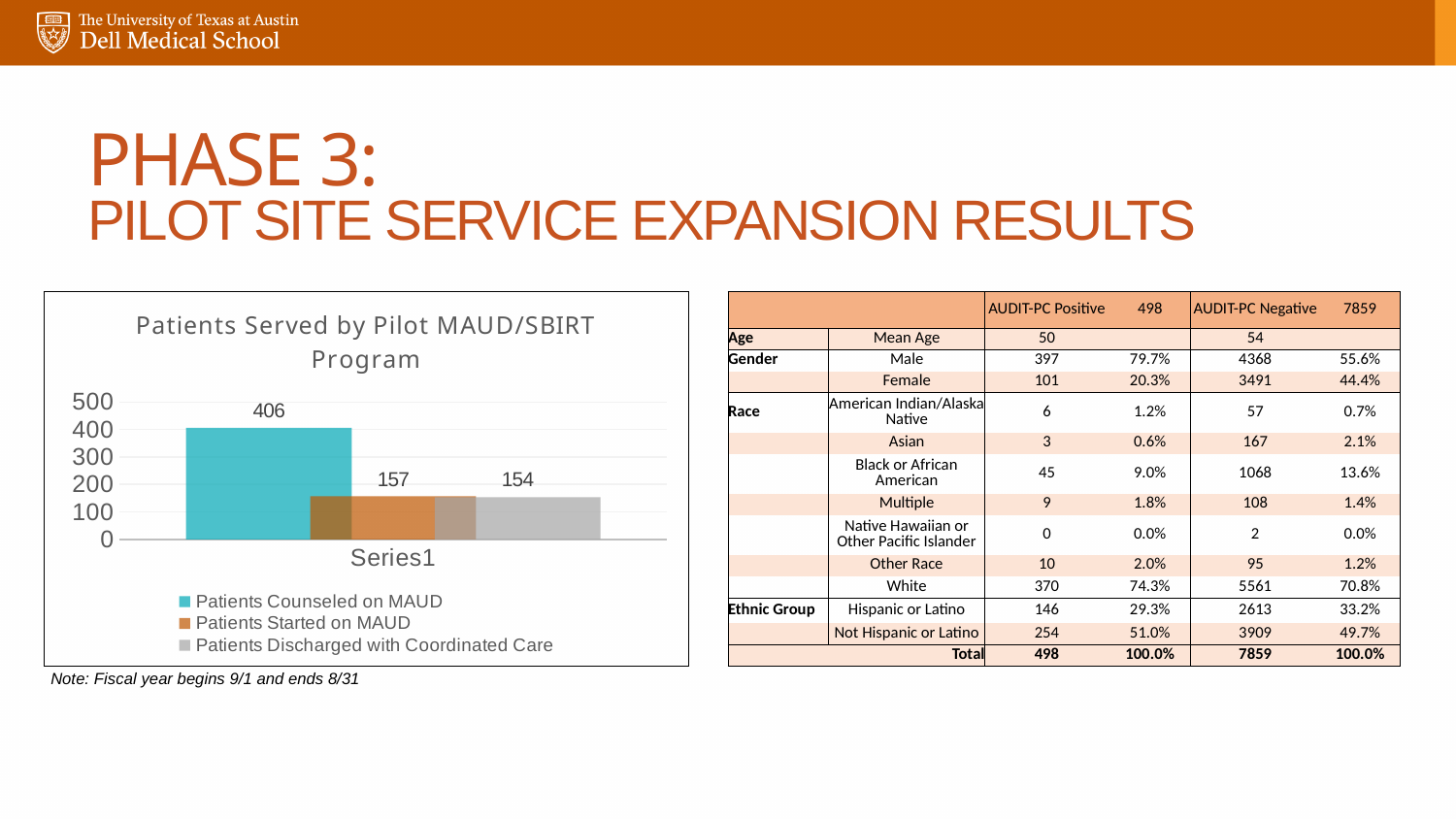
Which series has the highest value in the chart? Patients Counseled on MAUD What is the title of the chart? Patients Served by Pilot MAUD/SBIRT Program What is the difference between Patients Started on MAUD and Patients Discharged with Coordinated Care? 3 What is the value for Patients Started on MAUD in the chart? 157 How many series does the chart legend list? 3 What is the difference between Patients Counseled on MAUD and Patients Started on MAUD? 249 Which is larger: Patients Counseled on MAUD or Patients Discharged with Coordinated Care? Patients Counseled on MAUD What is the value for Patients Counseled on MAUD in the chart? 406 What is the value for Patients Discharged with Coordinated Care in the chart? 154 Is the value for Patients Counseled on MAUD greater or less than 300? greater Which series has the lowest value in the chart? Patients Discharged with Coordinated Care What kind of chart is shown on the slide? Bar chart